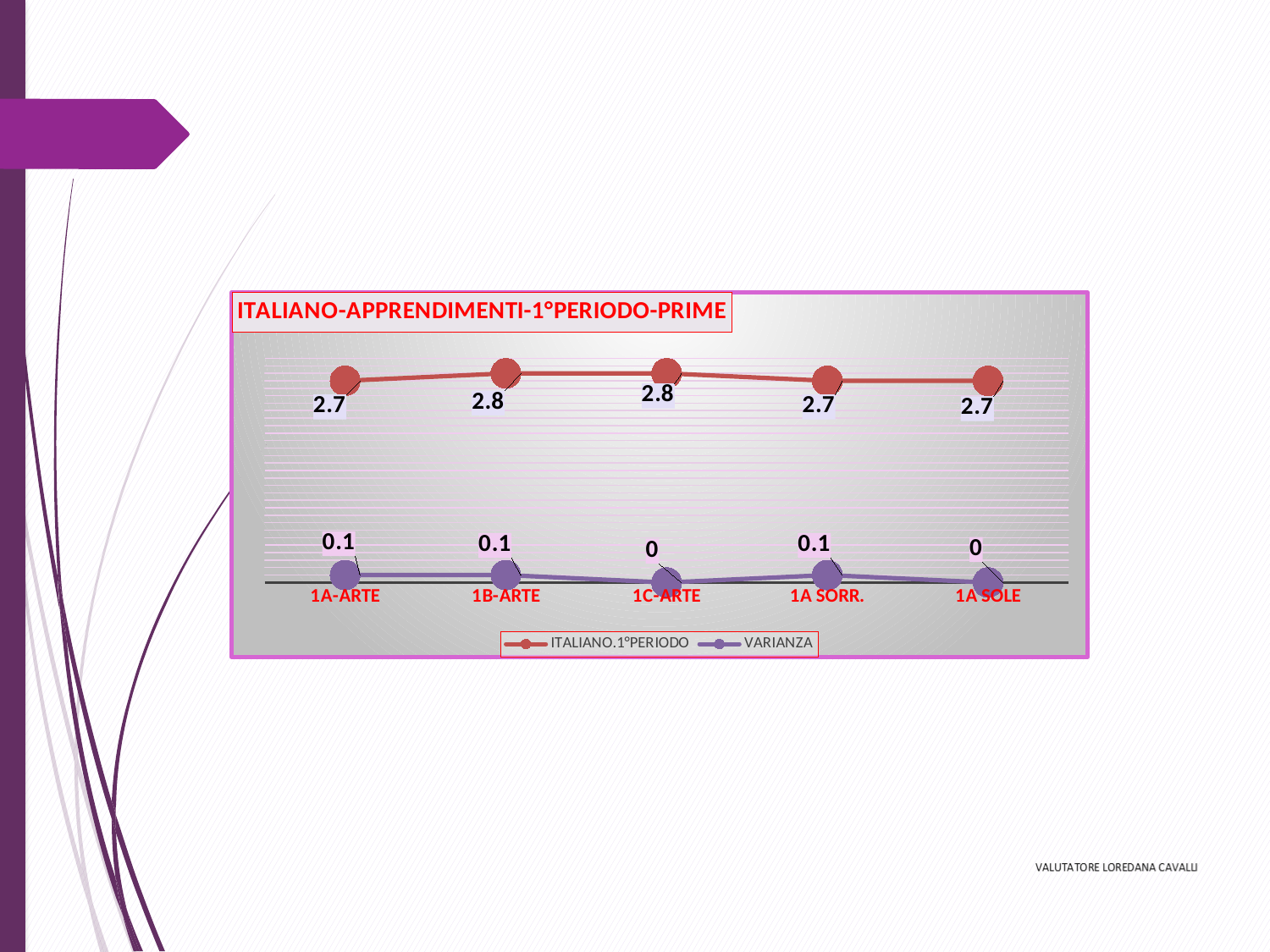
Which categories have the highest ITALIANO.1°PERIODO value? 1B-ARTE and 1C-ARTE Which is larger, the ITALIANO.1°PERIODO value for 1C-ARTE or for 1A SORR.? 1C-ARTE What is the ITALIANO.1°PERIODO value for 1A SOLE? 2.7 What is the VARIANZA value for 1C-ARTE? 0 What is the VARIANZA value for 1A SORR.? 0.1 What is the ITALIANO.1°PERIODO value for 1B-ARTE? 2.8 What is the difference between the ITALIANO.1°PERIODO values for 1B-ARTE and 1A-ARTE? 0.1 What kind of chart is shown on the slide? Line chart Which categories have the lowest VARIANZA value? 1C-ARTE and 1A SOLE What is the title of the chart? ITALIANO-APPRENDIMENTI-1°PERIODO-PRIME How many categories are shown on the x axis? 5 How many series does the legend list? 2